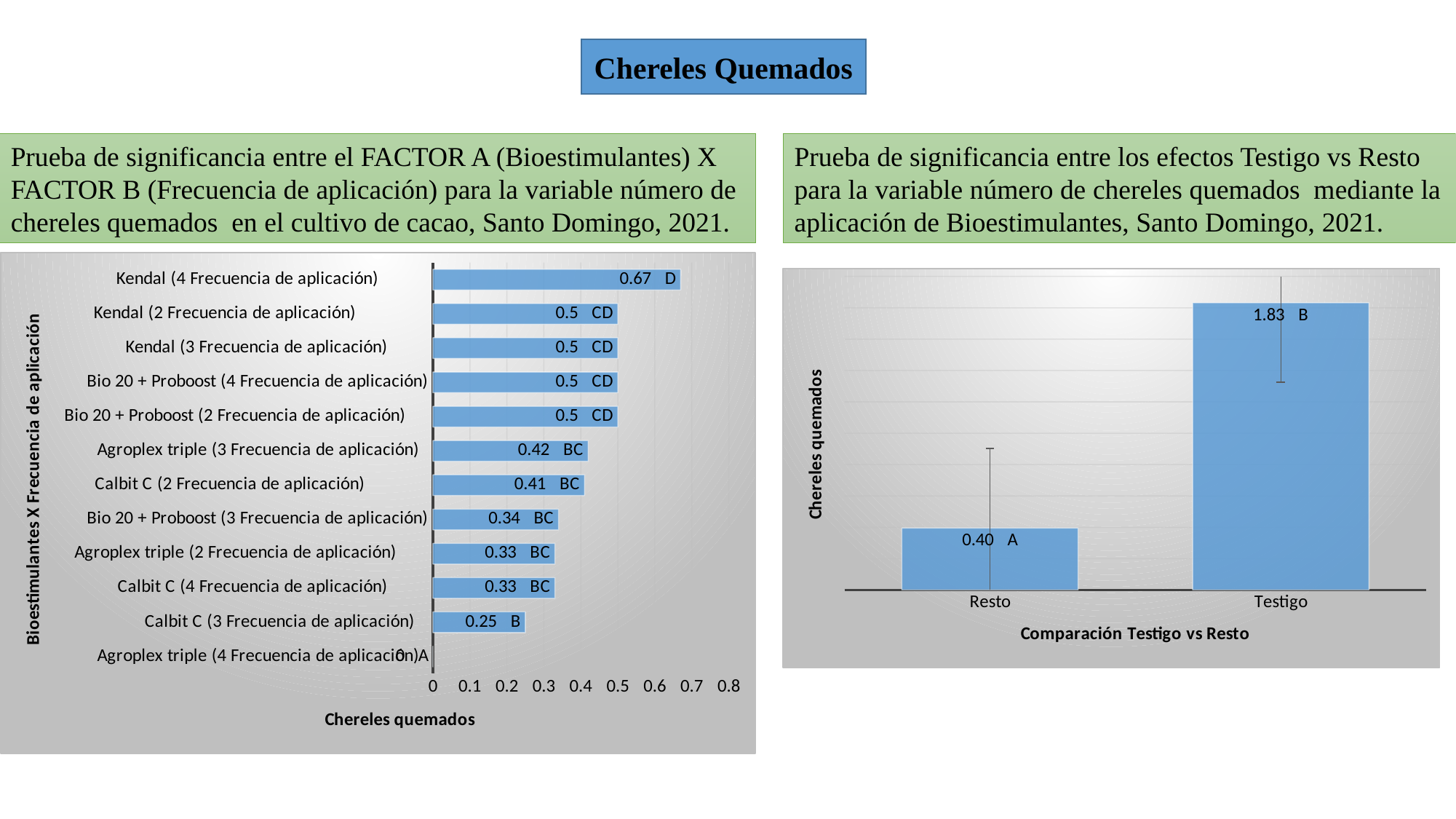
In the left chart, what is the difference between the values for Kendal (4 Frecuencia de aplicación) and Calbit C (3 Frecuencia de aplicación)? 0.42 In the left chart, which category has the lowest value? Agroplex triple (4 Frecuencia de aplicación) How many categories are shown in the left chart? 12 In the right chart, what is the value for Testigo? 1.83 In the left chart, what is the value for Kendal (4 Frecuencia de aplicación)? 0.67 In the right chart, what is the value for Resto? 0.40 In the left chart, what is the value for Calbit C (3 Frecuencia de aplicación)? 0.25 In the left chart, which is larger: the value for Agroplex triple (3 Frecuencia de aplicación) or Bio 20 + Proboost (3 Frecuencia de aplicación)? Agroplex triple (3 Frecuencia de aplicación) In the right chart, what is the difference between the values for Testigo and Resto? 1.43 What kind of chart is the left chart? Bar chart What is the x-axis title of the right chart? Comparación Testigo vs Resto In the left chart, which category has the highest value? Kendal (4 Frecuencia de aplicación)